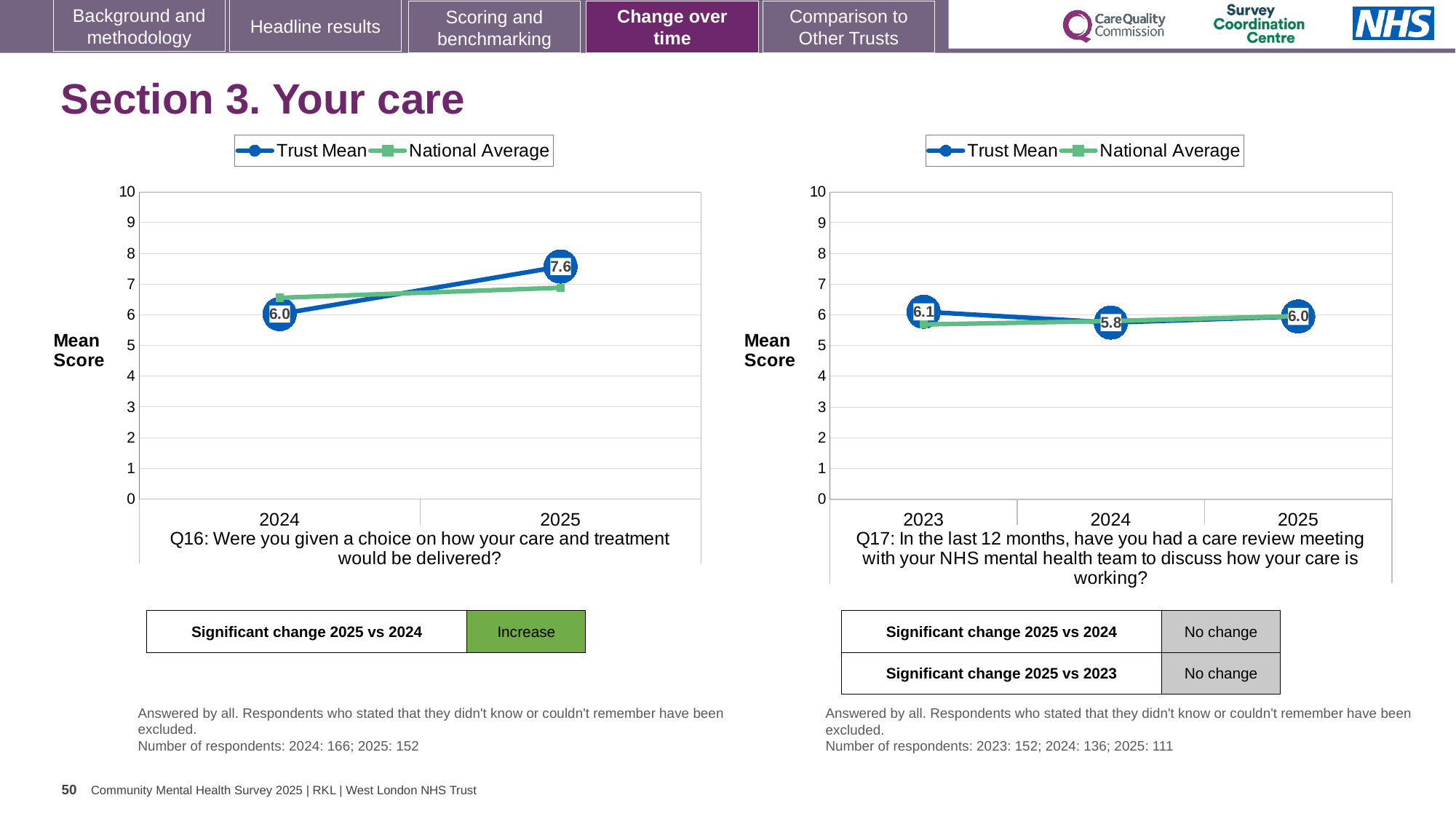
On the right chart (Q17), in which year is the Trust Mean lowest? 2024 How many series does the legend of the right chart (Q17) list? 2 On the right chart (Q17), in which year is the Trust Mean highest? 2023 What type of chart is the left chart (Q16)? line chart On the right chart (Q17), how many years are shown on the x axis? 3 On the left chart (Q16), what is the Trust Mean score for 2024? 6.0 On the left chart (Q16), is the National Average for 2024 greater or less than 6? greater On the left chart (Q16), which is higher in 2025, the Trust Mean or the National Average? Trust Mean On the left chart (Q16), does the Trust Mean rise or fall from 2024 to 2025? rise On the left chart (Q16), by how much did the Trust Mean change from 2024 to 2025? 1.6 On the right chart (Q17), what is the Trust Mean score for 2024? 5.8 On the left chart (Q16), what is the Trust Mean score for 2025? 7.6